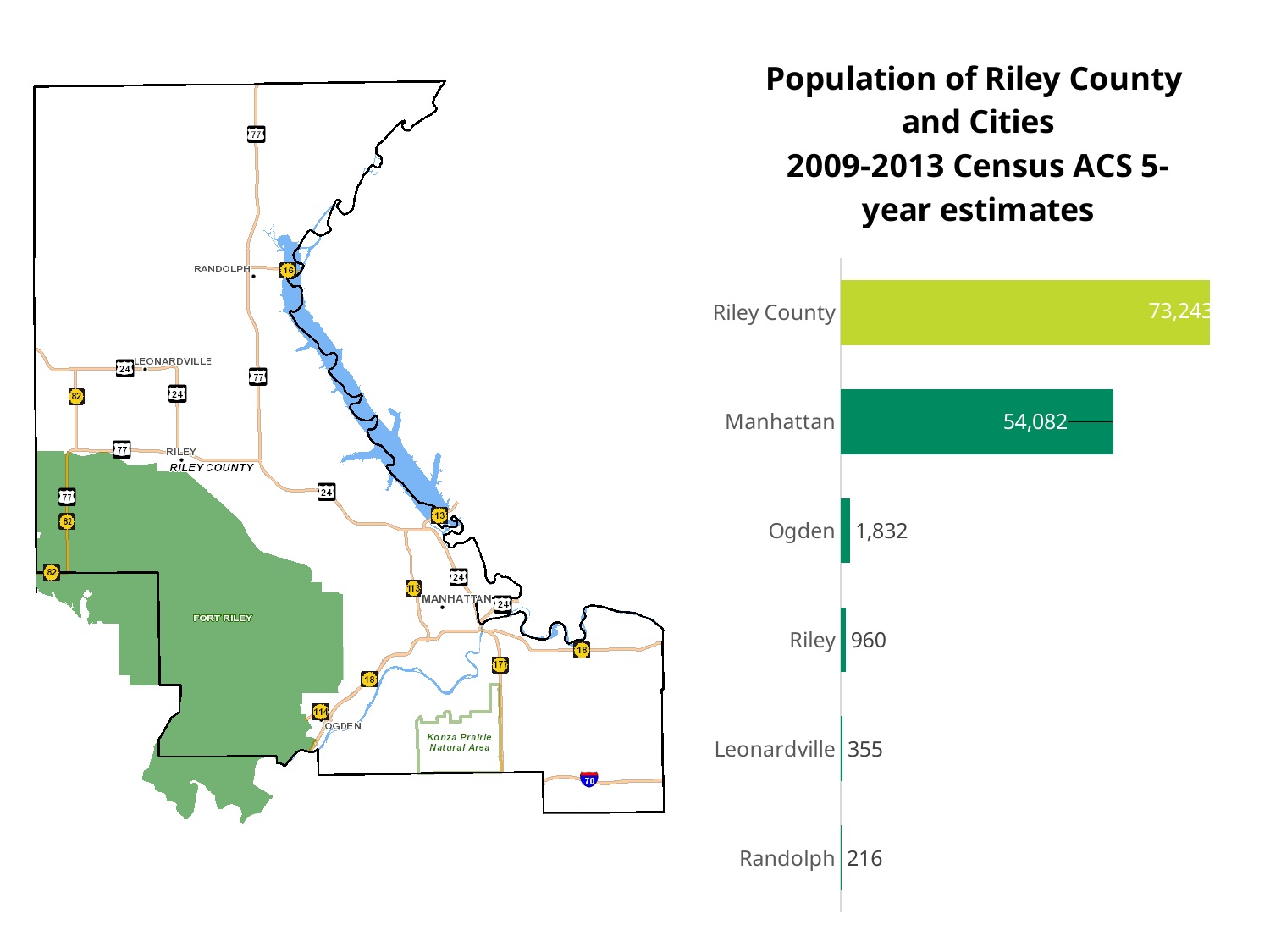
What is the population shown for Manhattan? 54,082 Which has a larger population, Leonardville or Randolph? Leonardville What is the population shown for Ogden? 1,832 What is the population shown for Leonardville? 355 What kind of chart is shown on the slide? Bar chart What is the difference between the populations of Riley County and Manhattan? 19,161 What is the difference between the populations of Ogden and Riley? 872 How many categories are plotted in the chart? 6 Which category has the lowest value in the chart? Randolph What is the population shown for Randolph? 216 What is the title of the chart? Population of Riley County and Cities 2009-2013 Census ACS 5-year estimates Which category has the highest value in the chart? Riley County